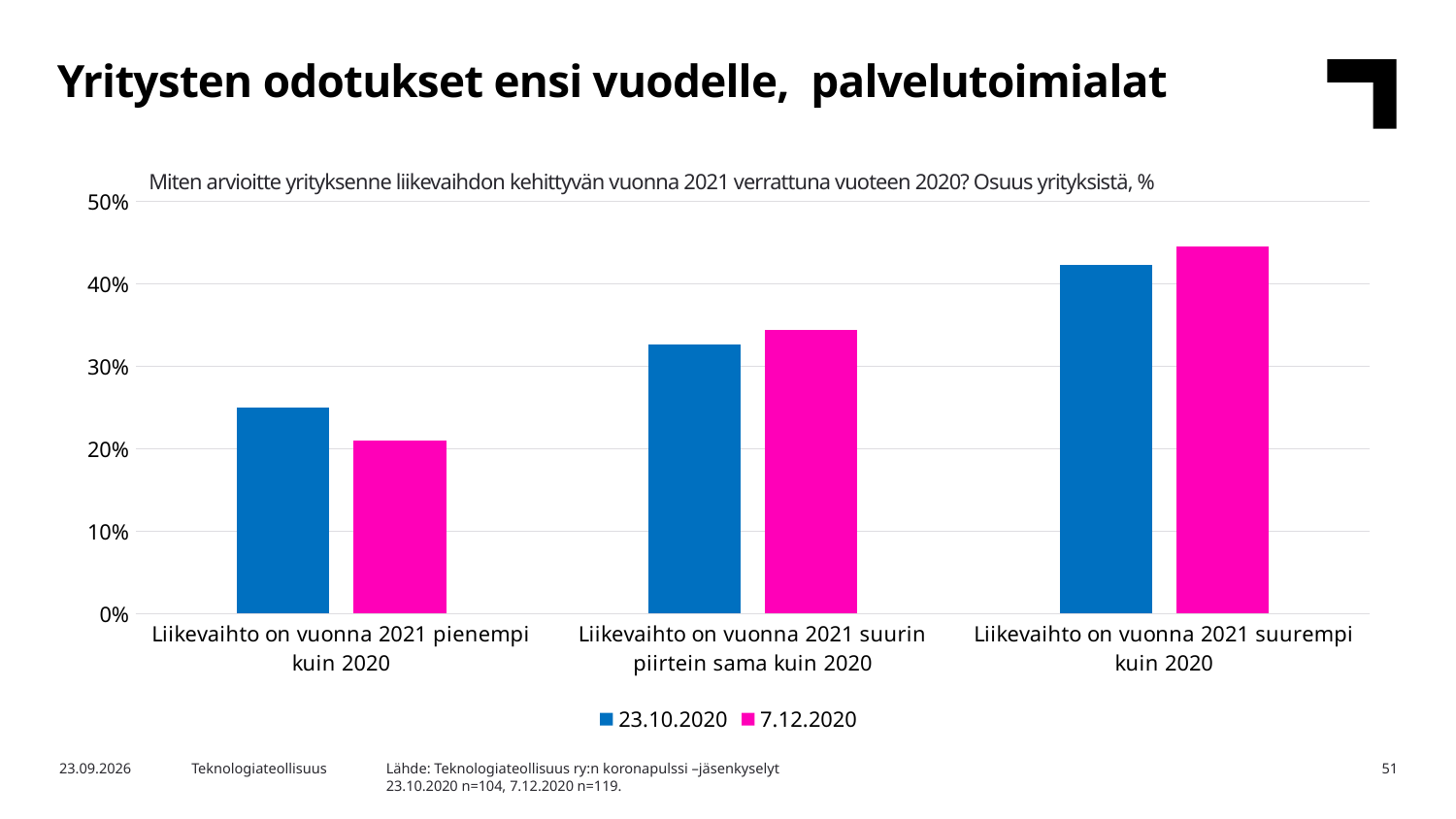
Is the 23.10.2020 value for 'Liikevaihto on vuonna 2021 suurin piirtein sama kuin 2020' greater or less than 30%? greater How many series does the chart's legend list? 2 For 'Liikevaihto on vuonna 2021 pienempi kuin 2020', which series has the larger value, 23.10.2020 or 7.12.2020? 23.10.2020 What are the two entries in the chart's legend? 23.10.2020 and 7.12.2020 Is the 7.12.2020 value for 'Liikevaihto on vuonna 2021 suurempi kuin 2020' greater or less than 50%? less What kind of chart is shown on the slide? bar chart Which category has the highest value for the 7.12.2020 series? Liikevaihto on vuonna 2021 suurempi kuin 2020 Is the 23.10.2020 value for 'Liikevaihto on vuonna 2021 pienempi kuin 2020' greater or less than 20%? greater Do the values for the 7.12.2020 series rise or fall from left to right across the categories? rise Which category has the lowest value for the 23.10.2020 series? Liikevaihto on vuonna 2021 pienempi kuin 2020 How many categories are shown on the x axis of the chart? 3